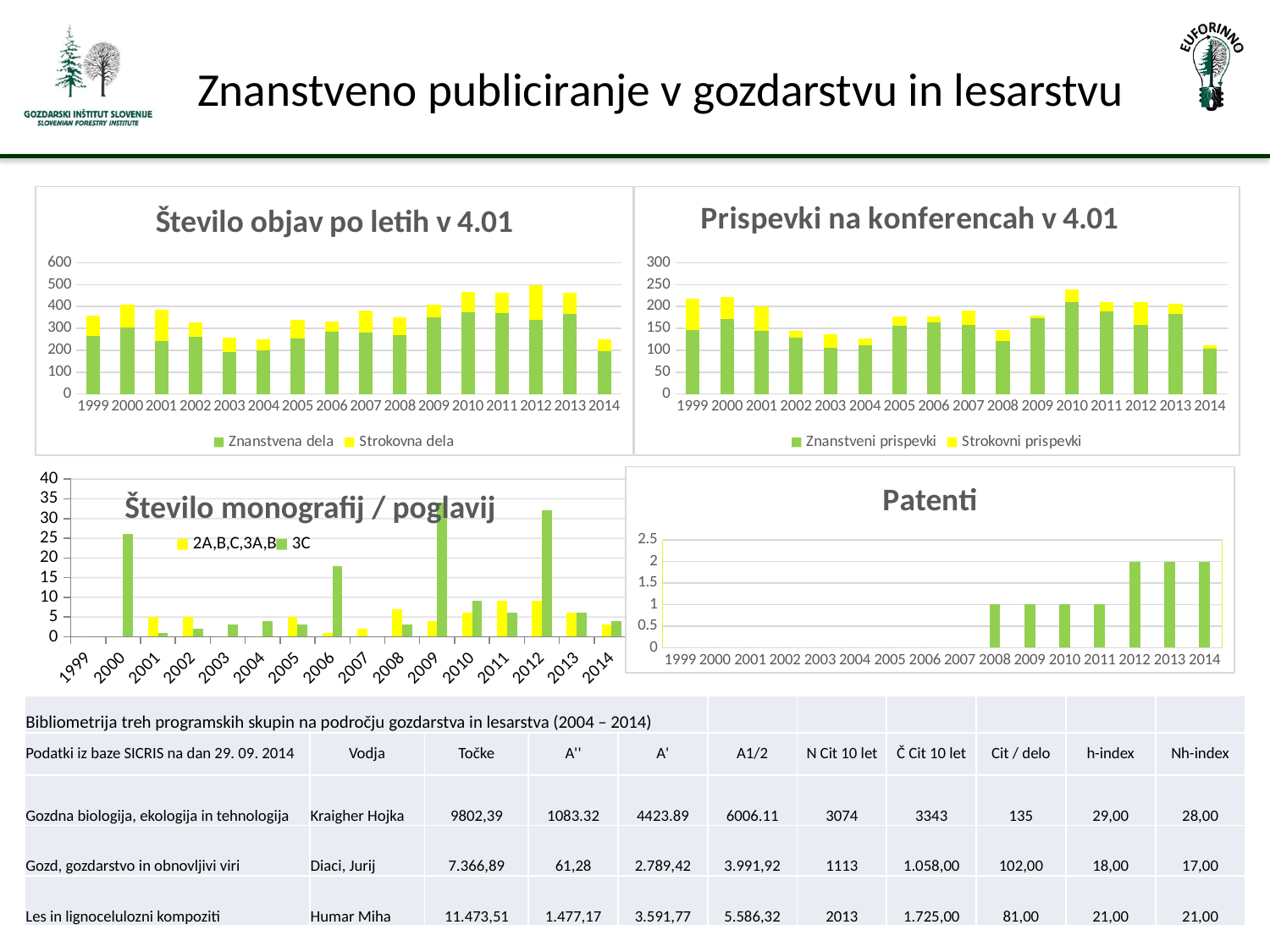
In the chart titled "Število objav po letih v 4.01", which year has the highest total bar? 2012 What kind of chart is the chart titled "Število objav po letih v 4.01"? Stacked bar chart In the chart titled "Patenti", which is larger, the value for 2013 or the value for 2010? 2013 In the chart titled "Število monografij / poglavij", is the 3C value for 2000 greater or less than 20? greater In the chart titled "Patenti", what is the value for 2012? 2 In the chart titled "Prispevki na konferencah v 4.01", how many series does the legend list? 2 In the chart titled "Patenti", what is the value for 2008? 1 In the chart titled "Prispevki na konferencah v 4.01", which year has the highest total bar? 2010 In the chart titled "Patenti", how many years have a bar with a value greater than zero? 7 In the chart titled "Patenti", what is the difference between the values for 2014 and 2011? 1 In the chart titled "Prispevki na konferencah v 4.01", is the total value for 2014 greater or less than 150? less In the chart titled "Število objav po letih v 4.01", is the total value for 2014 greater or less than 300? less